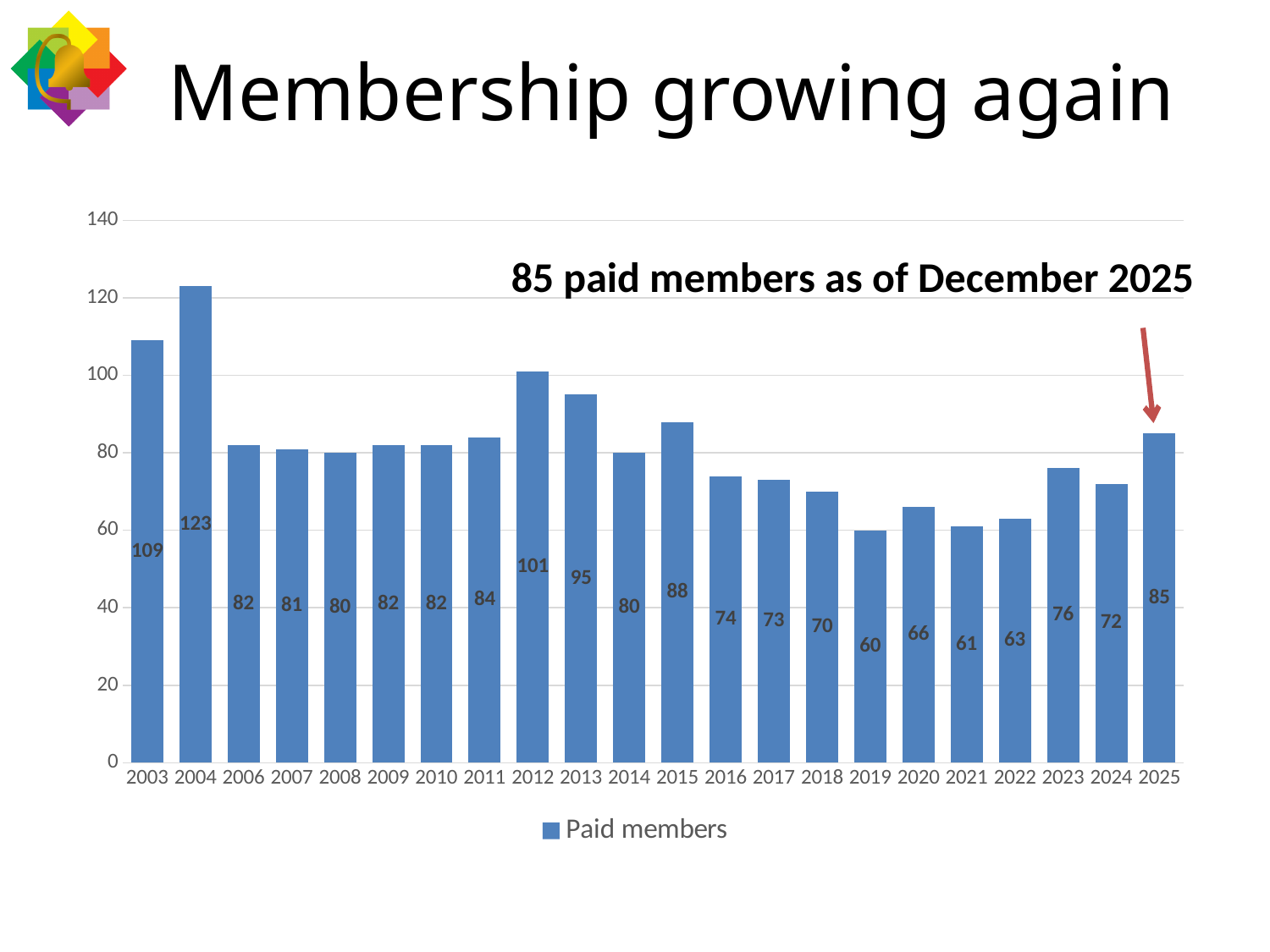
What kind of chart is shown on the slide? Bar chart Which year has the highest number of paid members? 2004 How many paid members were there in 2025? 85 By how much did paid members increase from 2024 to 2025? 13 Which year has the lowest number of paid members? 2019 What is the difference in paid members between 2004 and 2003? 14 Which year had more paid members, 2013 or 2015? 2013 How many years are shown on the x axis? 22 How many series does the legend list? 1 What is the legend entry for the series? Paid members Did paid members rise or fall from 2015 to 2019? Fall What is the value for 2012? 101